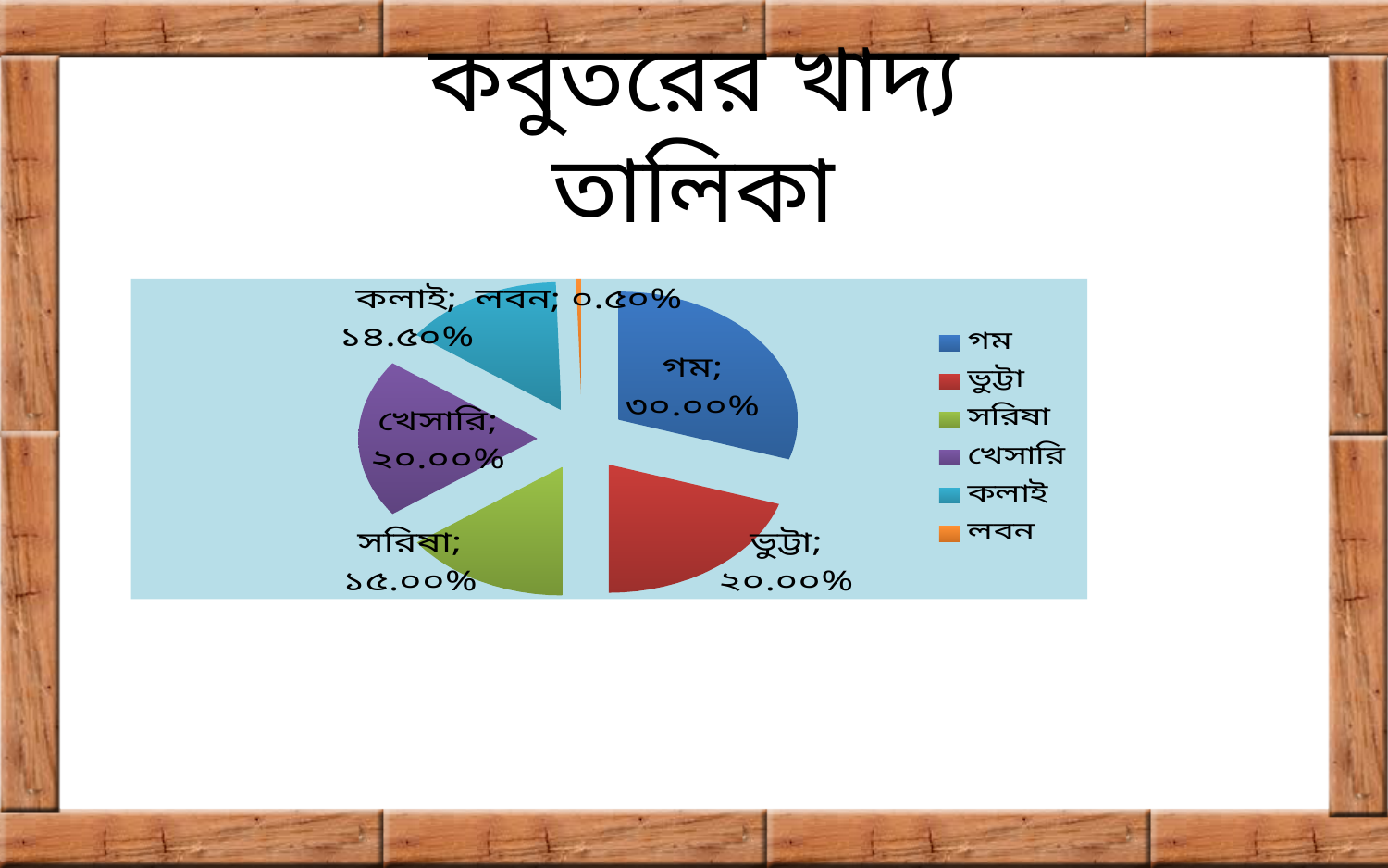
What is the value for লবন in the pie chart? ০.৫০% Which is larger, the value for খেসারি or the value for সরিষা? খেসারি How many entries does the legend list? 6 How many categories does the pie chart have? 6 What kind of chart is shown on the slide? Pie chart Which category has the smallest slice in the pie chart? লবন What is the difference between the values for গম and ভুট্টা? ১০.০০% What is the title of the slide containing the pie chart? কবুতরের খাদ্য তালিকা What is the value for সরিষা in the pie chart? ১৫.০০% Which category has the largest slice in the pie chart? গম What is the value for কলাই in the pie chart? ১৪.৫০% What is the value for গম in the pie chart? ৩০.০০%